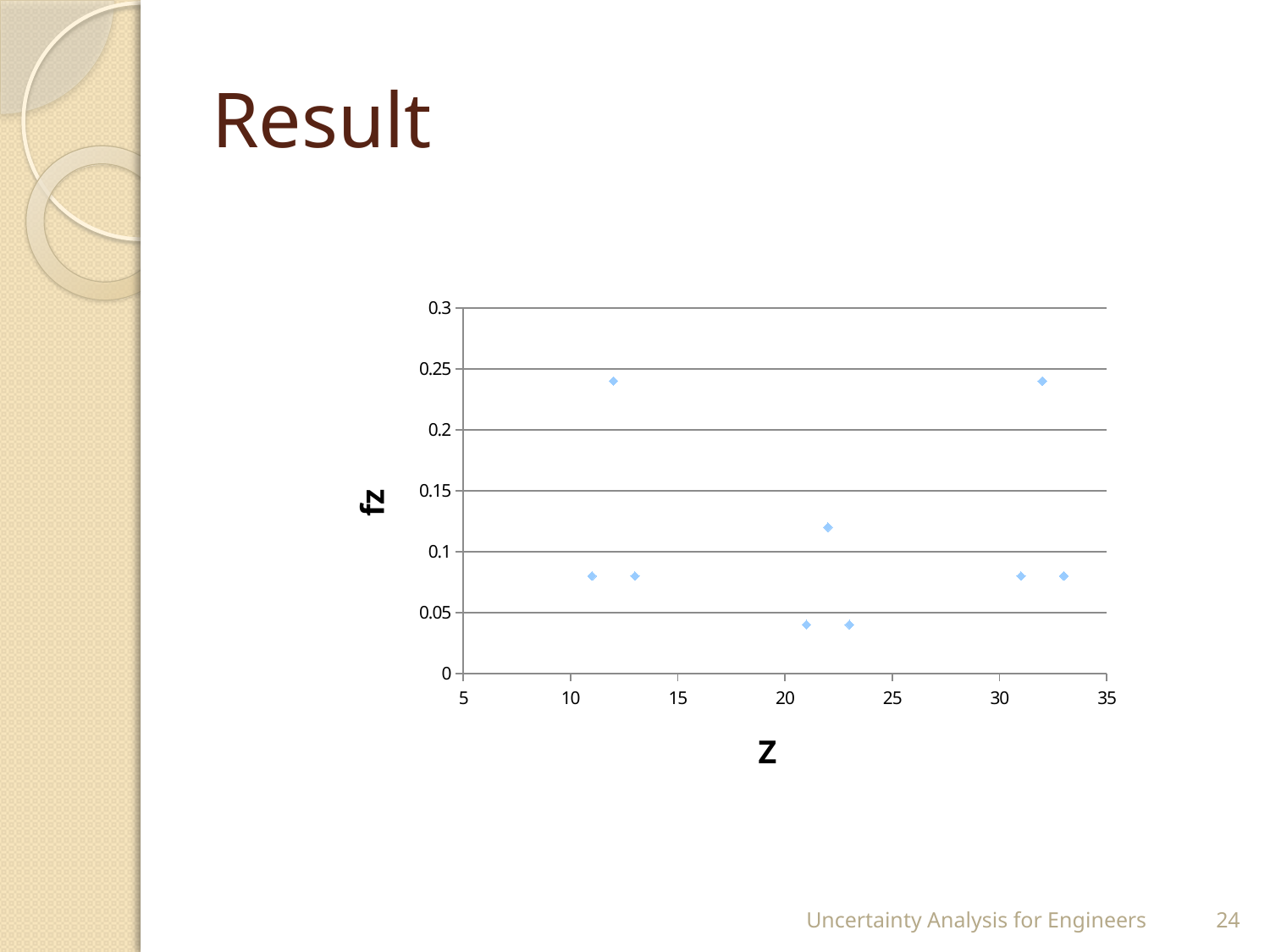
How many data points are plotted on the chart? 9 What is the label on the horizontal axis of the chart? Z Which point has the larger fz value, the one at Z = 12 or the one at Z = 22? Z = 12 Is the fz value of the point at Z = 11 greater or less than 0.1? less What is the label on the vertical axis of the chart? fz Is the fz value of the point at Z = 12 greater or less than 0.2? greater Which point has the larger fz value, the one at Z = 11 or the one at Z = 12? Z = 12 Is the fz value of the point at Z = 21 greater or less than 0.05? less Which point has the larger fz value, the one at Z = 21 or the one at Z = 22? Z = 22 What kind of chart is shown on the slide? scatter chart